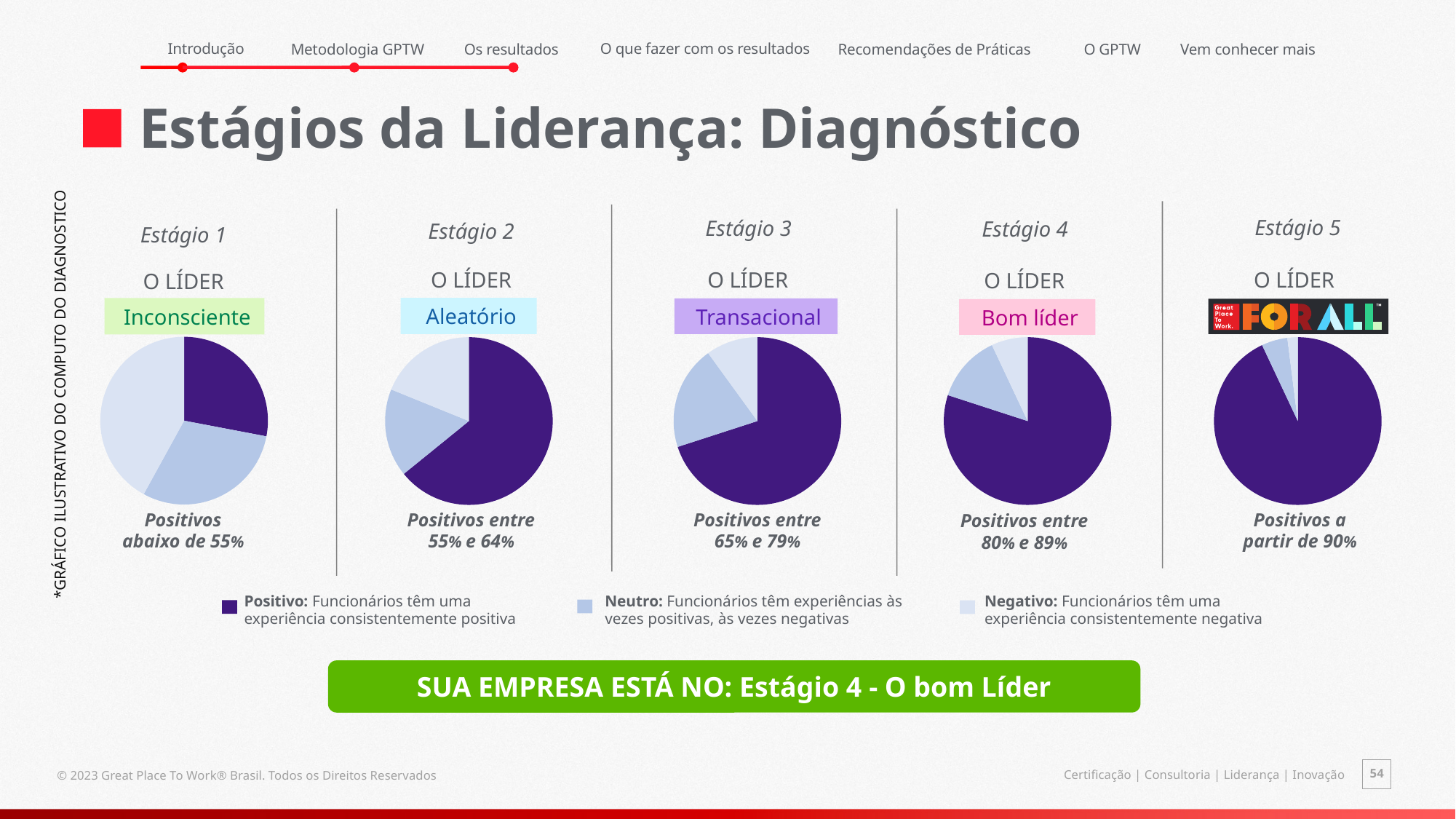
What range of positive responses is printed below the Estágio 4 pie chart? Positivos entre 80% e 89% How many categories does the legend list for the pie charts? 3 In the Estágio 2 pie chart, which category has the largest slice? Positivo In the Estágio 5 pie chart, which category has the largest slice? Positivo What leader label is shown above the Estágio 3 pie chart? Transacional In the Estágio 4 pie chart, which category has the smallest slice? Negativo What kind of charts are shown on the slide? Pie charts Does the Positivo share of the pie charts rise or fall from Estágio 1 to Estágio 5? Rise In the Estágio 3 pie chart, which slice is larger, Positivo or Neutro? Positivo In the Estágio 3 pie chart, which slice is larger, Neutro or Negativo? Neutro How many pie charts are shown on the slide? 5